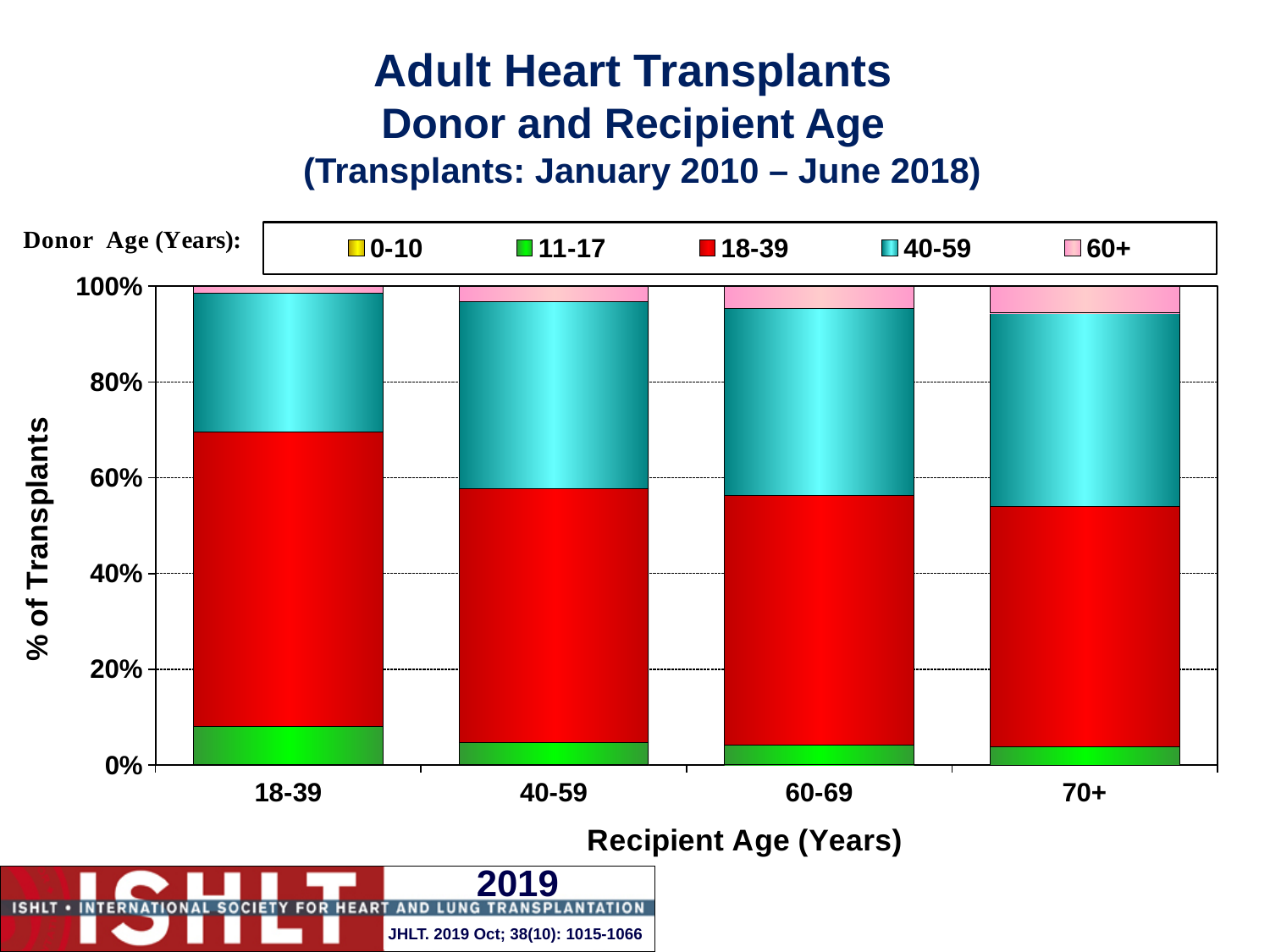
Which recipient age group has the largest share of donors aged 11-17? 18-39 Is the share of donors aged 18-39 larger for recipients aged 18-39 or for recipients aged 70+? 18-39 Does the share of donors aged 18-39 rise or fall as recipient age increases from 18-39 to 70+? Fall How many recipient age groups are shown on the x axis? 4 Which recipient age group has the smallest share of donors aged 60+? 18-39 In the 18-39 recipient bar, is the top of the 18-39 donor segment greater or less than 60%? greater What kind of chart is shown on the slide? Stacked bar chart What transplant period does the chart title cover? January 2010 – June 2018 Which recipient age group has the largest share of donors aged 18-39? 18-39 What is the label of the y axis? % of Transplants In the 70+ recipient bar, is the top of the 18-39 donor segment greater or less than 60%? less How many donor age groups does the legend list? 5